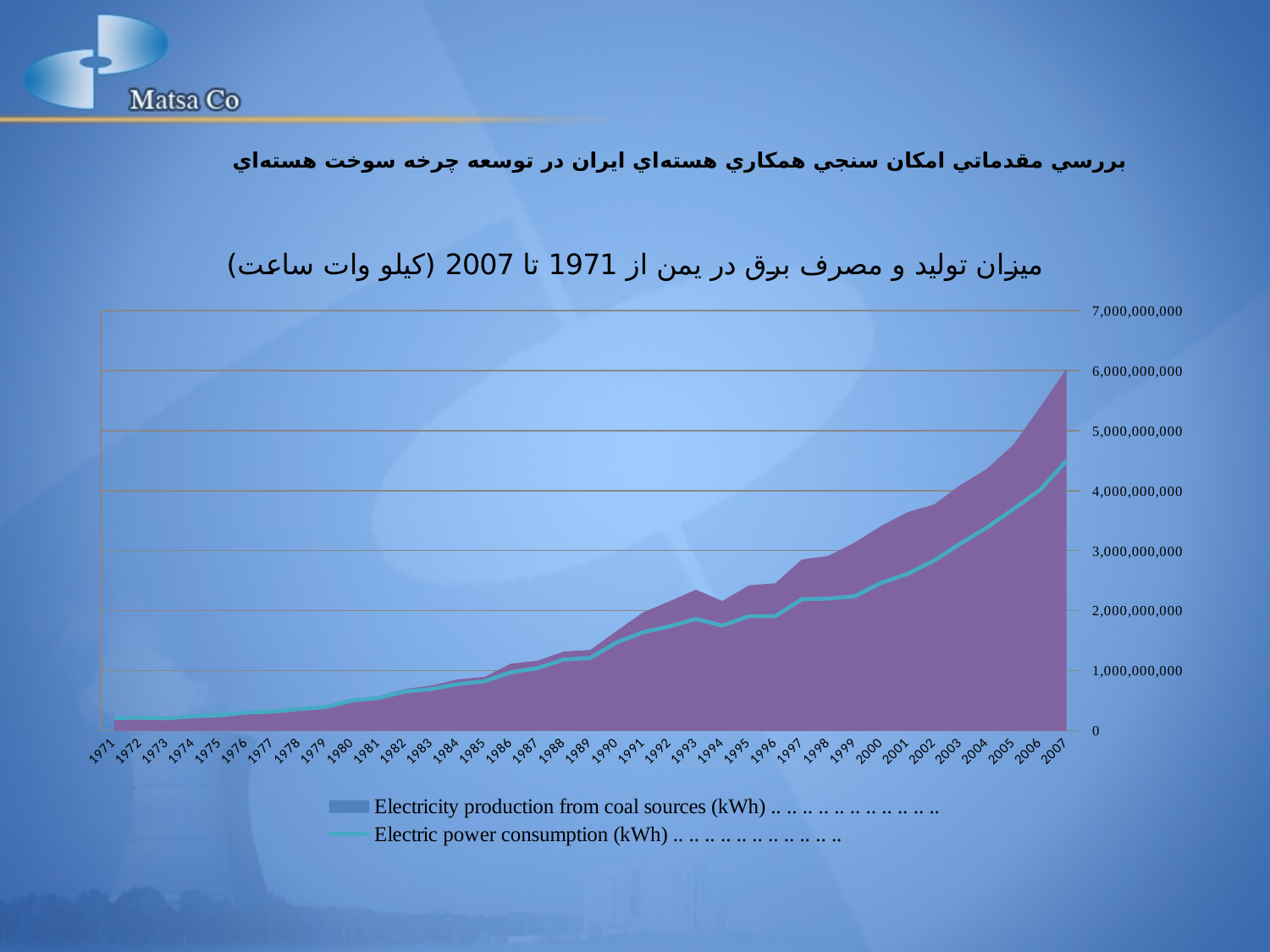
Is the electricity production value for 2001 greater or less than 3,000,000,000? greater How many years are plotted along the x axis? 37 How many series does the legend list? 2 Do the electricity production values generally rise or fall from 1971 to 2007? rise Is the electricity production value for 2007 greater or less than 5,000,000,000? greater What is the highest value shown on the y axis? 7,000,000,000 In which year is electricity production from coal sources highest? 2007 Is the electric power consumption value for 2007 greater or less than 5,000,000,000? less In 2007, which is larger: electricity production from coal sources or electric power consumption? Electricity production from coal sources What kind of chart is used to plot electricity production from coal sources? area chart